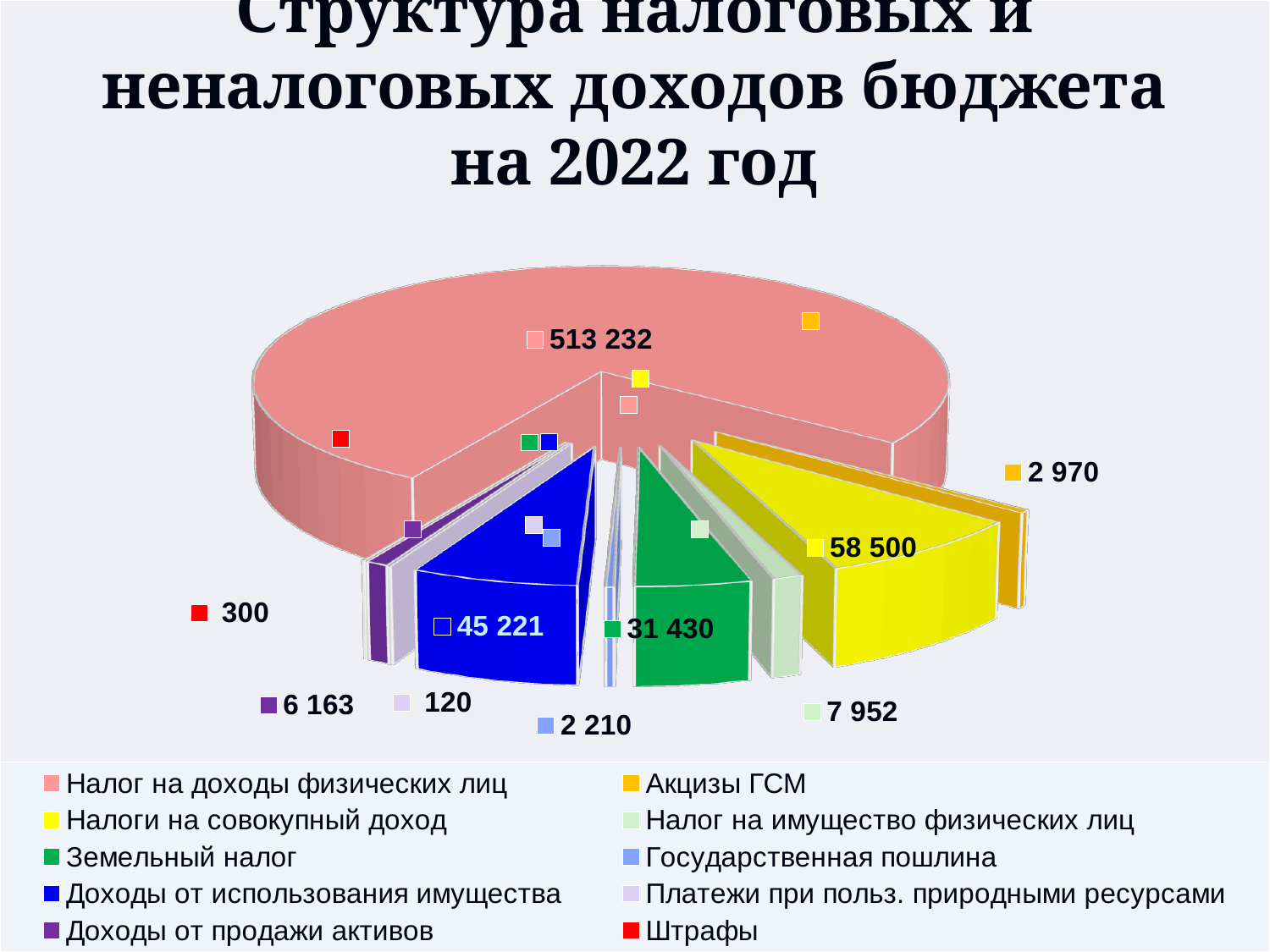
What type of chart is shown on the slide? pie chart What colour is the slice for Штрафы? red Which category has the smallest value? Платежи при польз. природными ресурсами What is the value for Налоги на совокупный доход? 58 500 How many categories does the pie chart have? 10 What is the value for Доходы от использования имущества? 45 221 What is the value for Налог на доходы физических лиц? 513 232 What is the value for Земельный налог? 31 430 What is the difference between Налоги на совокупный доход and Доходы от использования имущества? 13 279 Which category has the largest value? Налог на доходы физических лиц Which is larger: Земельный налог or Налог на имущество физических лиц? Земельный налог What is the value for Платежи при польз. природными ресурсами? 120